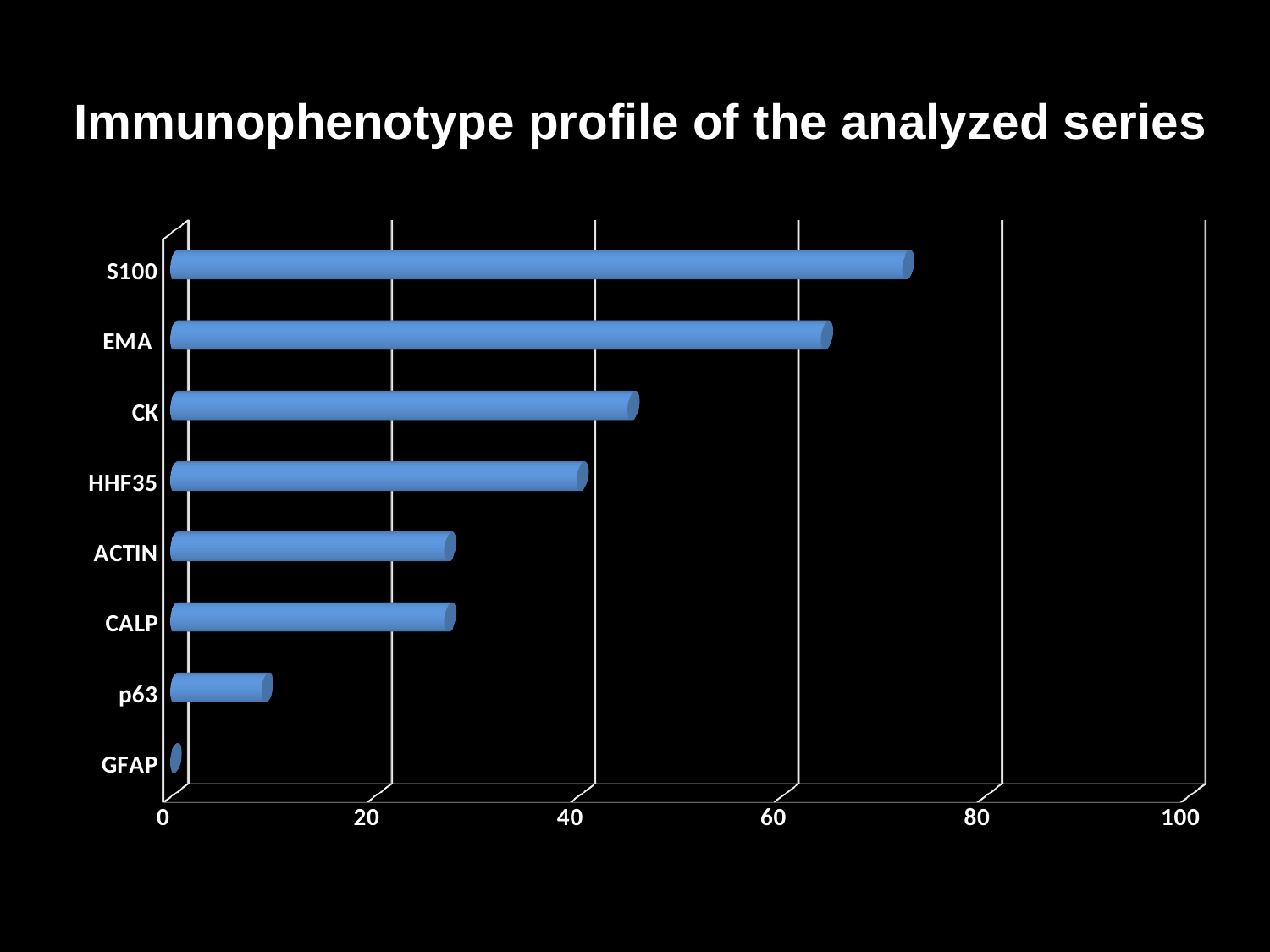
Which has the larger value, HHF35 or p63? HHF35 What is the title of the chart? Immunophenotype profile of the analyzed series Is the value for S100 greater or less than 60? greater What kind of chart is shown on the slide? bar chart Is the value for p63 greater or less than 20? less Is the value for CK greater or less than 40? greater Which marker has the highest value in the chart? S100 Which marker has the lowest value in the chart? GFAP Which has the larger value, S100 or CK? S100 How many categories (markers) are plotted in the chart? 8